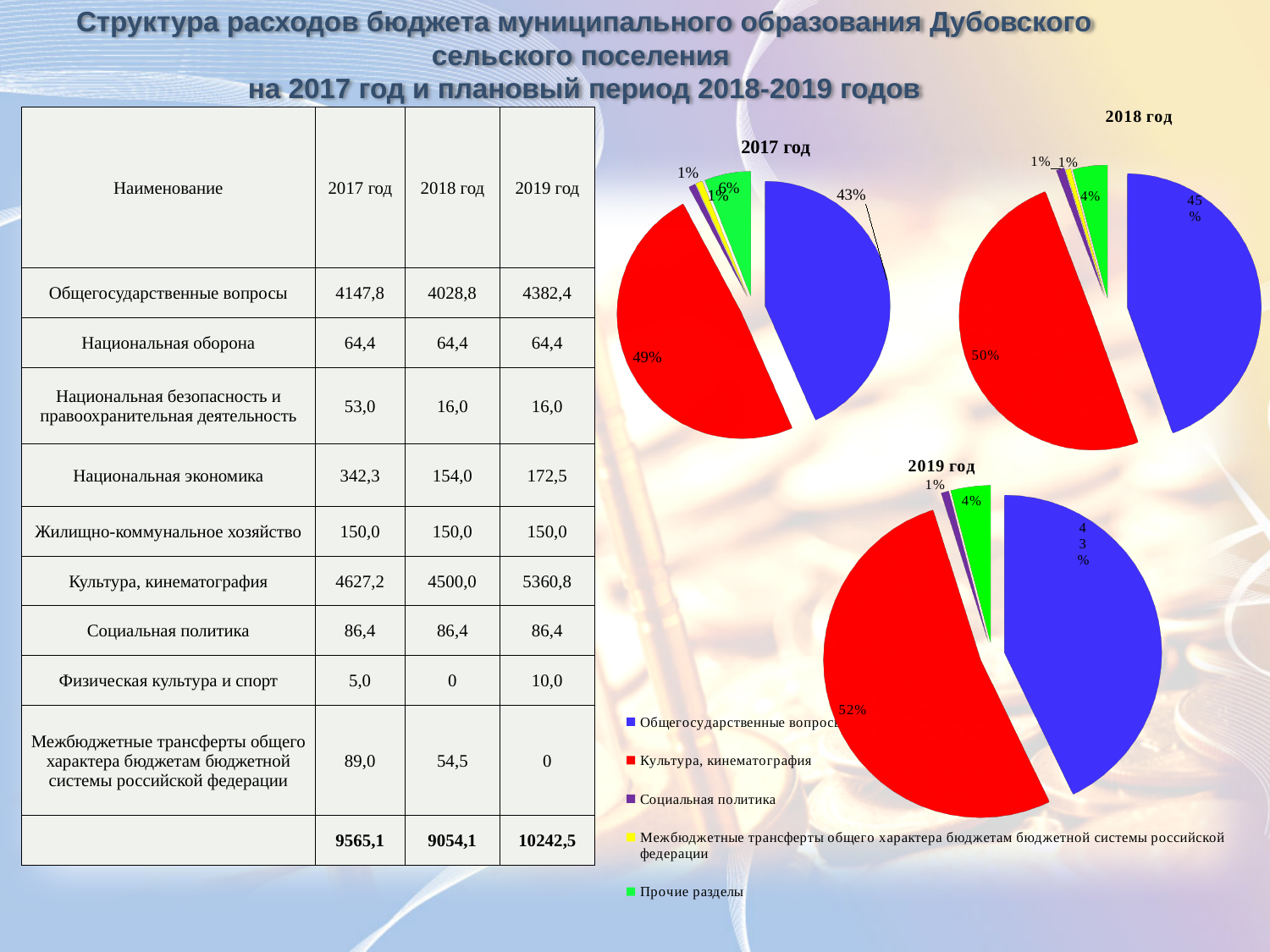
In the 2018 год pie chart, what share is labelled for Культура, кинематография (the red slice)? 50% How many pie charts are on the slide? 3 How many categories does the legend list for the pie charts? 5 In the 2018 год pie chart, what share is labelled for Общегосударственные вопросы (the blue slice)? 45% In the 2018 год pie chart, which is larger: Общегосударственные вопросы or Культура, кинематография? Культура, кинематография In the 2017 год pie chart, what share is labelled for Культура, кинематография (the red slice)? 49% In the 2019 год pie chart, by how many percentage points does the Культура, кинематография share exceed the Общегосударственные вопросы share? 9 In the 2019 год pie chart, what share is labelled for Прочие разделы (the green slice)? 4% In the 2017 год pie chart, what share is labelled for Общегосударственные вопросы (the blue slice)? 43% In the 2019 год pie chart, which category has the largest slice? Культура, кинематография What kind of charts are shown on the slide? Pie charts In the 2019 год pie chart, what share is labelled for Культура, кинематография (the red slice)? 52%